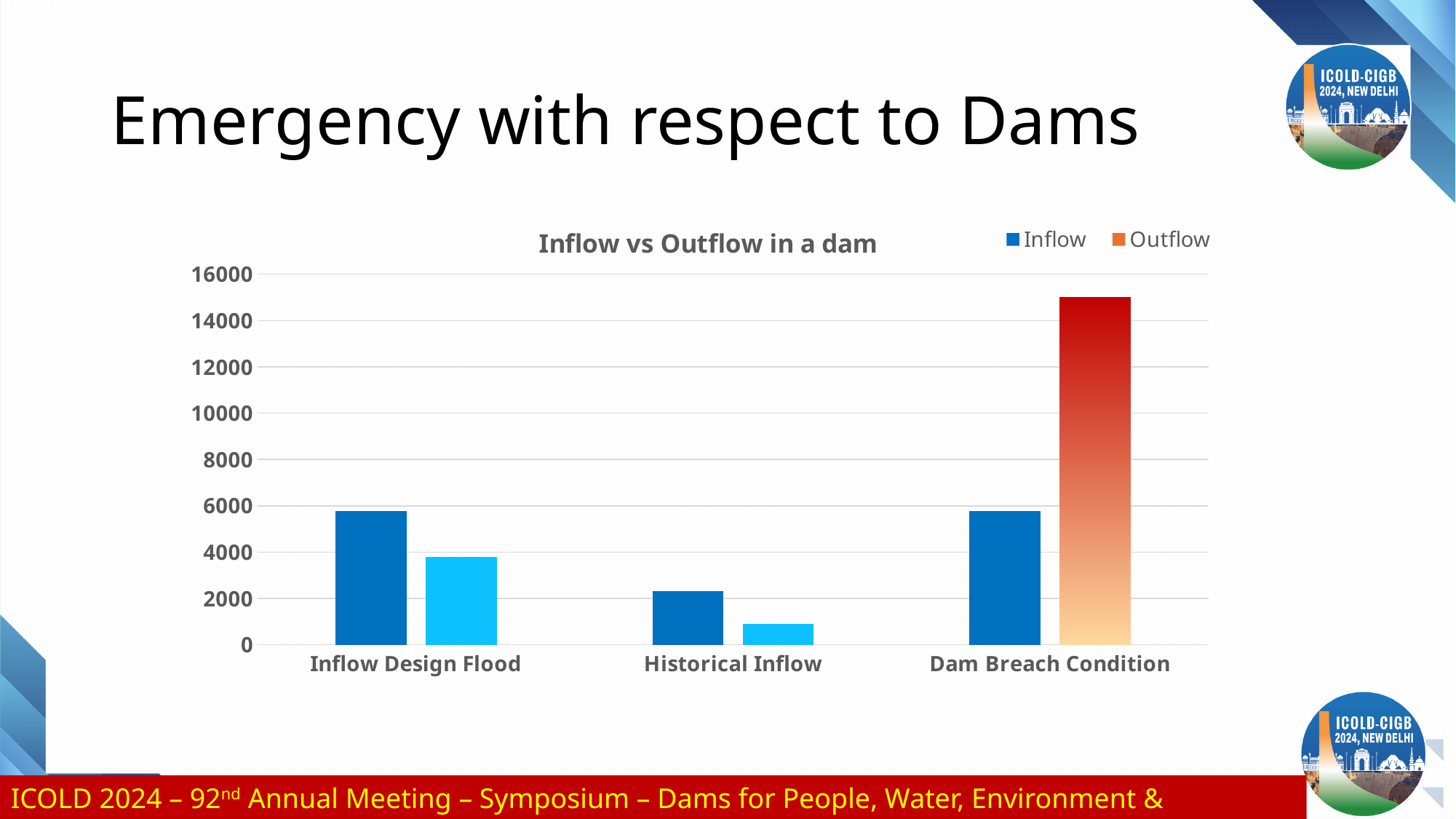
Which category has the highest Outflow value? Dam Breach Condition Which category has the lowest Inflow value? Historical Inflow What type of chart is shown on the slide? Bar chart For Dam Breach Condition, which is larger, Inflow or Outflow? Outflow How many categories are shown on the x axis of the chart? 3 Is the Outflow value for Dam Breach Condition greater or less than 14000? greater What is the title of the chart? Inflow vs Outflow in a dam Is the Inflow value for Inflow Design Flood greater or less than 4000? greater For Inflow Design Flood, which is larger, Inflow or Outflow? Inflow Is the Outflow value for Historical Inflow greater or less than 2000? less Which category has the lowest Outflow value? Historical Inflow How many series does the chart legend list? 2